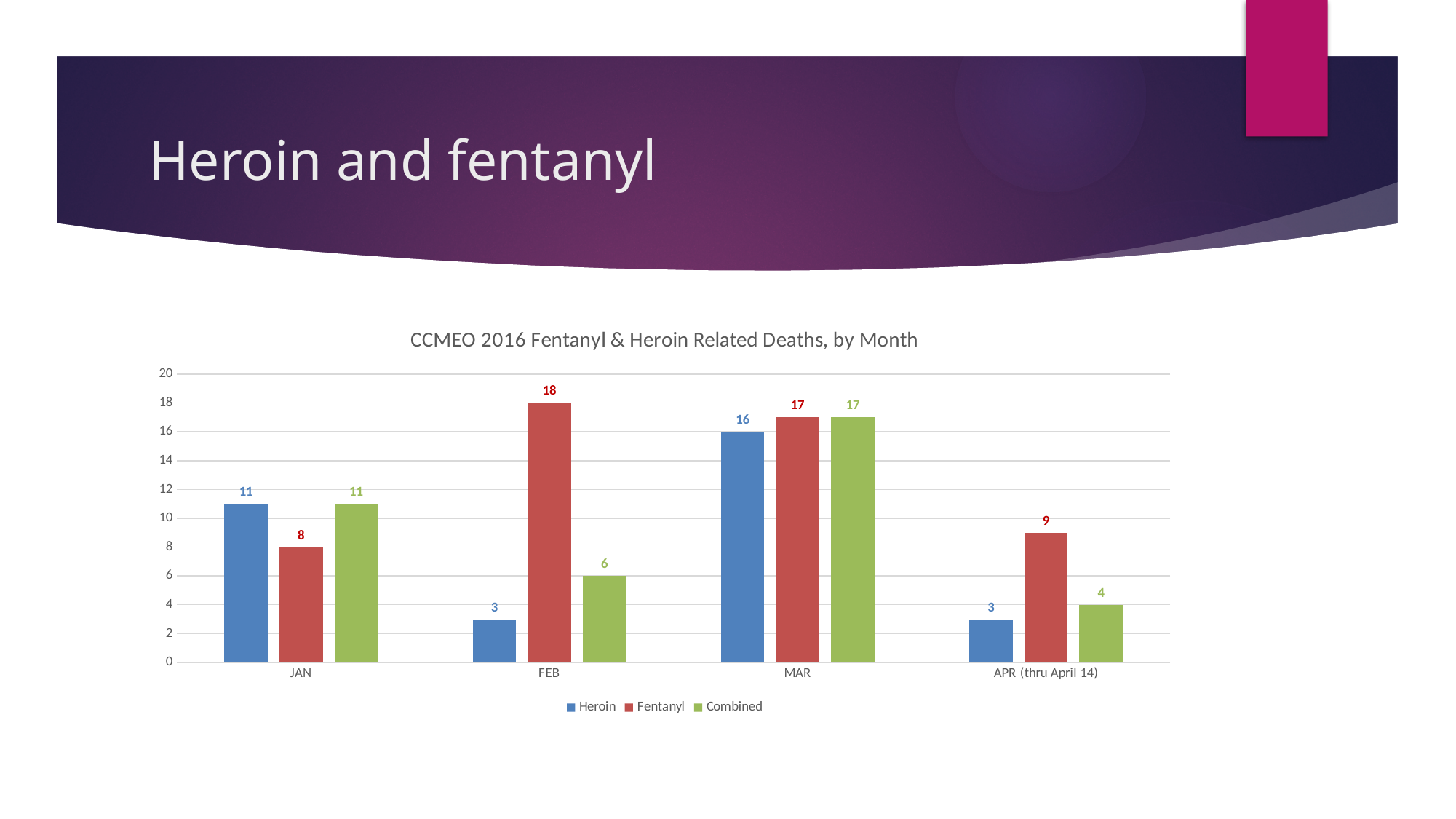
Which is larger, the Heroin value for JAN or the Fentanyl value for JAN? Heroin What is the Heroin value for MAR? 16 What is the Combined value for APR (thru April 14)? 4 What is the difference between the Fentanyl and Heroin values for FEB? 15 What is the Fentanyl value for FEB? 18 Which month has the highest Heroin value? MAR How many months are shown on the x axis? 4 What kind of chart is shown on the slide? bar chart Which month has the lowest Combined value? APR (thru April 14) How many series does the legend list? 3 Is the Fentanyl value for APR (thru April 14) greater or less than 10? less What is the title of the chart? CCMEO 2016 Fentanyl & Heroin Related Deaths, by Month